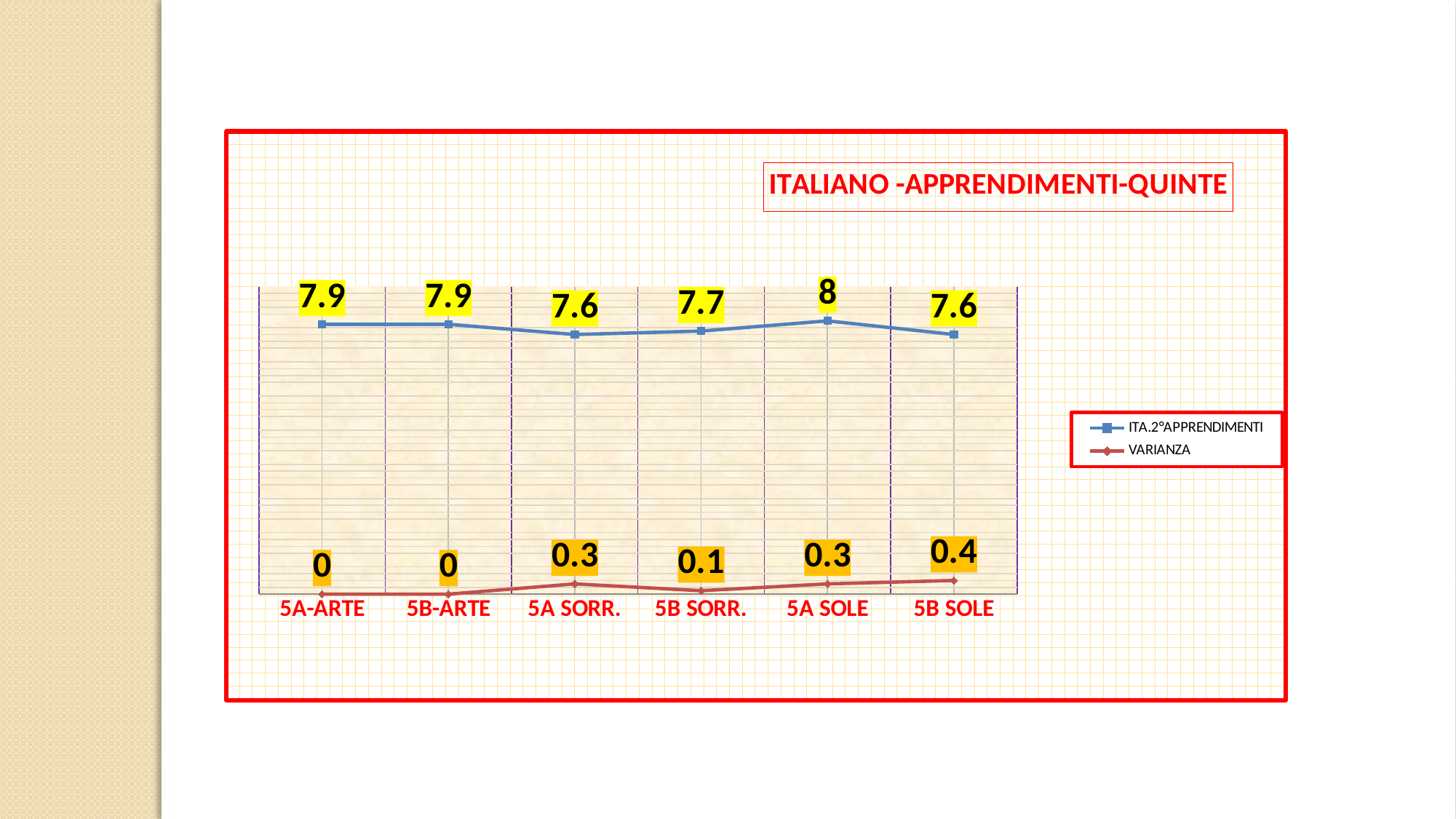
Which category has the highest VARIANZA value? 5B SOLE What is the VARIANZA value for 5B SORR.? 0.1 What is the title of the chart? ITALIANO -APPRENDIMENTI-QUINTE What is the difference between the ITA.2°APPRENDIMENTI values for 5A SOLE and 5B SOLE? 0.4 What kind of chart is shown on the slide? line chart Which category has the highest ITA.2°APPRENDIMENTI value? 5A SOLE What is the VARIANZA value for 5B SOLE? 0.4 What is the ITA.2°APPRENDIMENTI value for 5B SORR.? 7.7 Which is larger, the ITA.2°APPRENDIMENTI value for 5A-ARTE or for 5A SORR.? 5A-ARTE How many categories are shown on the x axis? 6 How many series does the legend list? 2 What is the ITA.2°APPRENDIMENTI value for 5A SOLE? 8